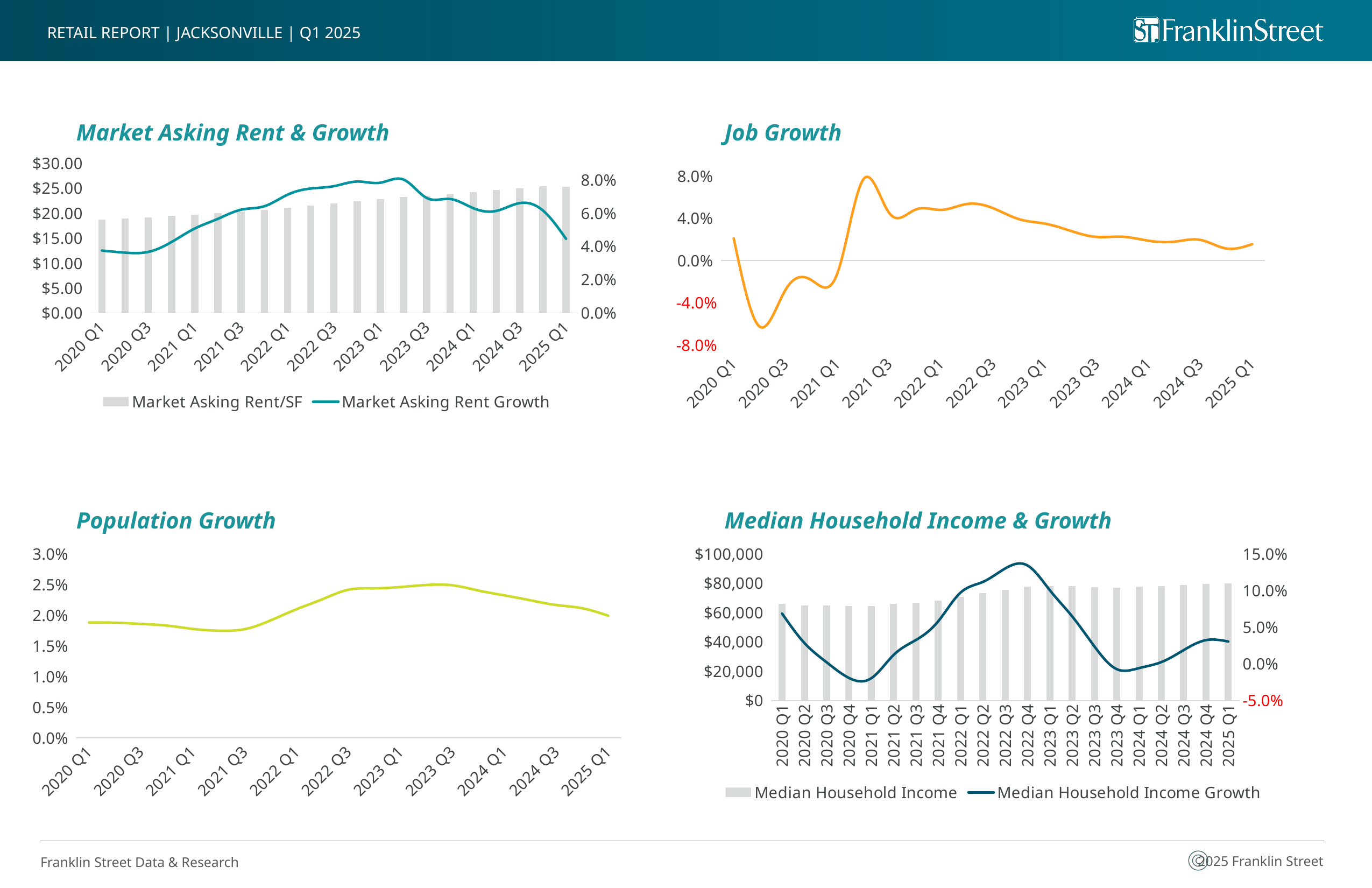
What kind of chart is the Job Growth chart? Line chart In the Market Asking Rent & Growth chart, do the Market Asking Rent/SF bars generally rise or fall from 2020 Q1 to 2025 Q1? rise In the Job Growth chart, is the value for 2021 Q1 greater or less than 0.0%? less In the Market Asking Rent & Growth chart, what kind of chart is used to show Market Asking Rent/SF? Bar chart In the Market Asking Rent & Growth chart, is the Market Asking Rent/SF for 2025 Q1 greater or less than $20.00? greater In the Median Household Income & Growth chart, in which quarter does Median Household Income Growth reach its highest point? 2022 Q4 In the Population Growth chart, is the value for 2023 Q3 greater or less than 2.0%? greater How many charts are shown on the slide? 4 How many series does the legend of the Market Asking Rent & Growth chart list? 2